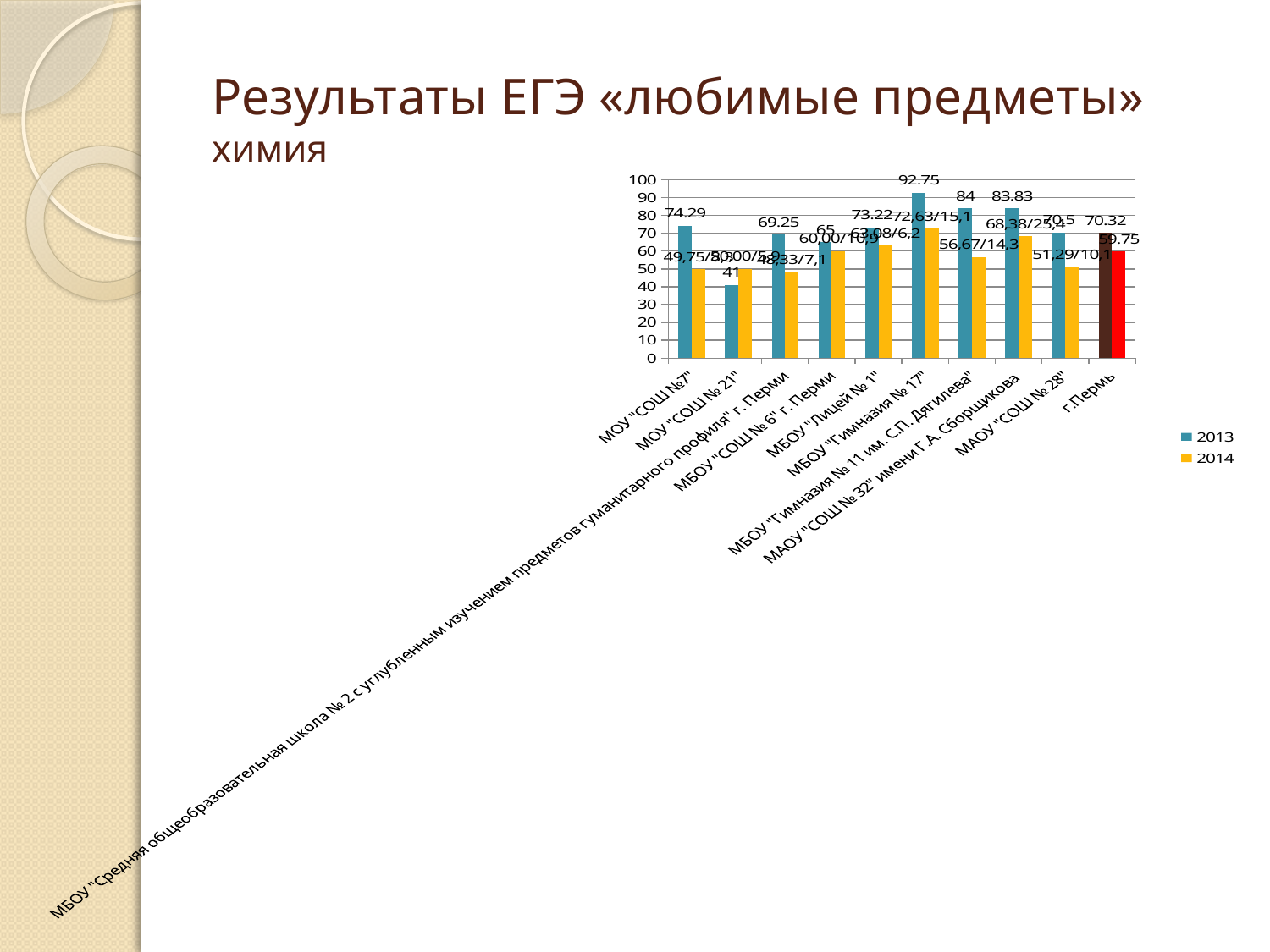
Which category has the highest 2013 value? МБОУ "Гимназия № 17" Which category has the lowest 2013 value? МОУ "СОШ № 21" What is the 2013 value for МОУ "СОШ № 21"? 41 For МОУ "СОШ №7", which is larger: the 2013 value or the 2014 value? 2013 How many categories are shown on the x axis of the chart? 10 What is the 2013 value for МАОУ "СОШ № 32" имени Г.А. Сборщикова? 83.83 What is the 2014 value for г.Пермь? 59.75 Is the 2014 value for МБОУ "Гимназия № 11 им. С.П. Дягилева" greater or less than 50? greater What is the difference between the 2013 values for МБОУ "Гимназия № 17" and МОУ "СОШ № 21"? 51.75 What is the 2013 value for МБОУ "Гимназия № 17"? 92.75 How many series does the legend list? 2 What kind of chart is shown on the slide? bar chart